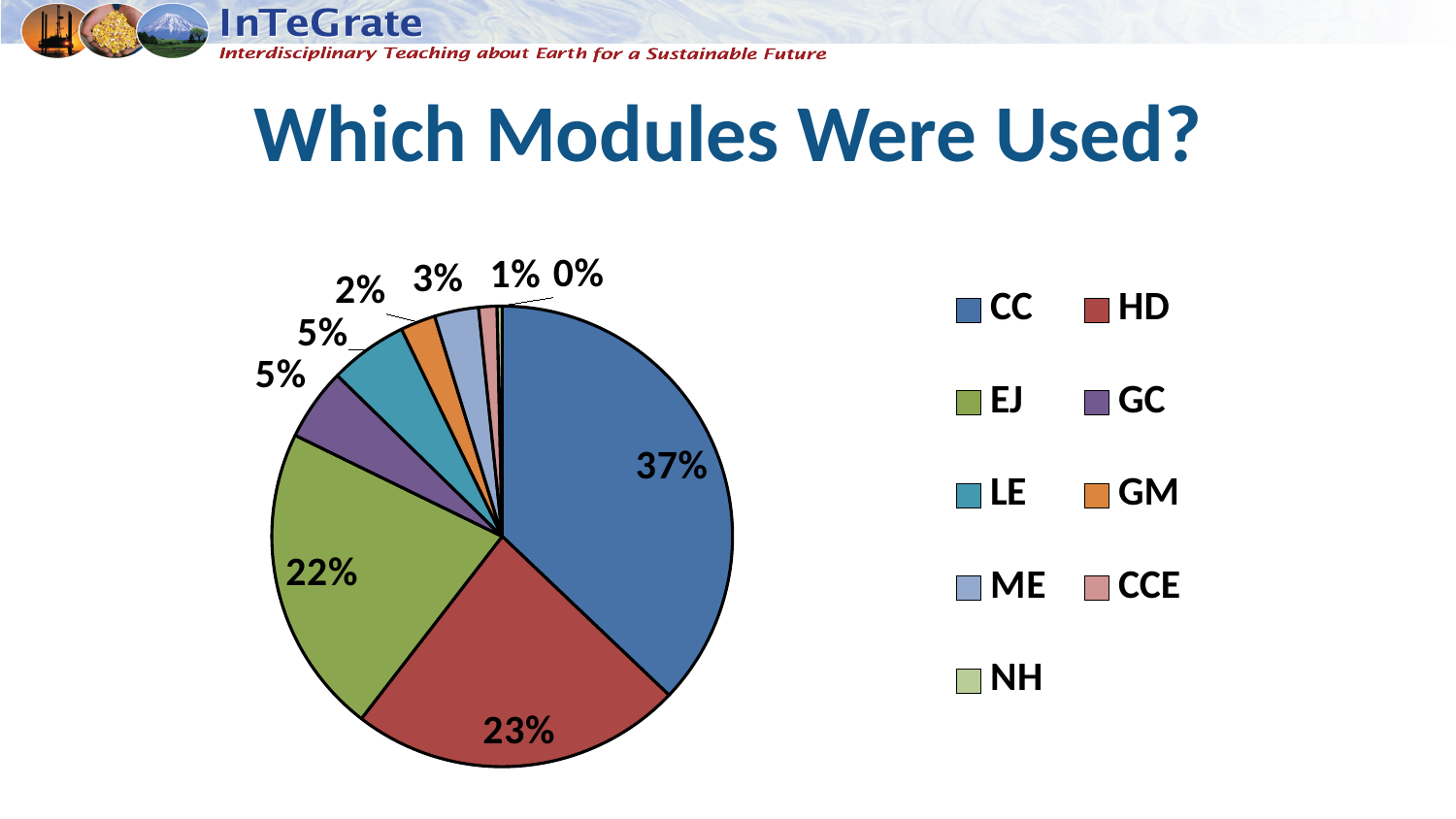
What share of the pie does GM have? 2% How many modules does the legend list? 9 Which module has the smallest share of the pie? NH What is the difference between the shares of CC and HD? 14% What share of the pie does CC have? 37% Which module has the largest share of the pie? CC What share of the pie does HD have? 23% What is the combined share of CC, HD and EJ? 82% Which has a larger share, EJ or GC? EJ What kind of chart is shown on the slide? pie chart What is the title of the chart? Which Modules Were Used?